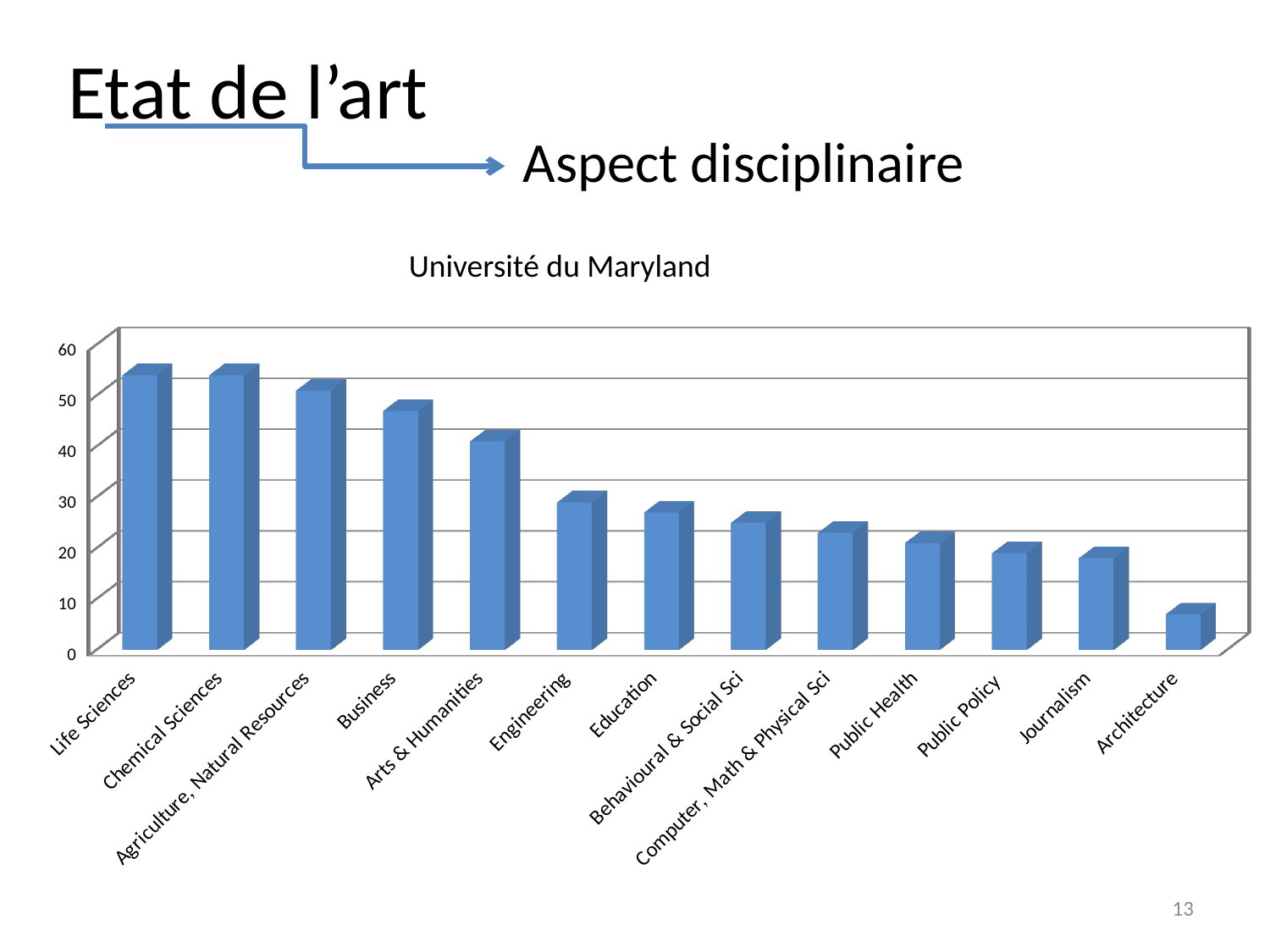
Do the values generally rise or fall moving from left to right along the x axis? fall Which discipline has the lowest value in the chart? Architecture How many categories (disciplines) are shown on the x axis of the chart? 13 Is the value for Engineering greater or less than 40? less Is the value for Life Sciences greater or less than 50? greater Is the value for Arts & Humanities greater or less than 30? greater What is the title shown above the chart? Université du Maryland What kind of chart is shown on the slide? bar chart Which has a larger value, Agriculture, Natural Resources or Arts & Humanities? Agriculture, Natural Resources Which has a larger value, Business or Engineering? Business